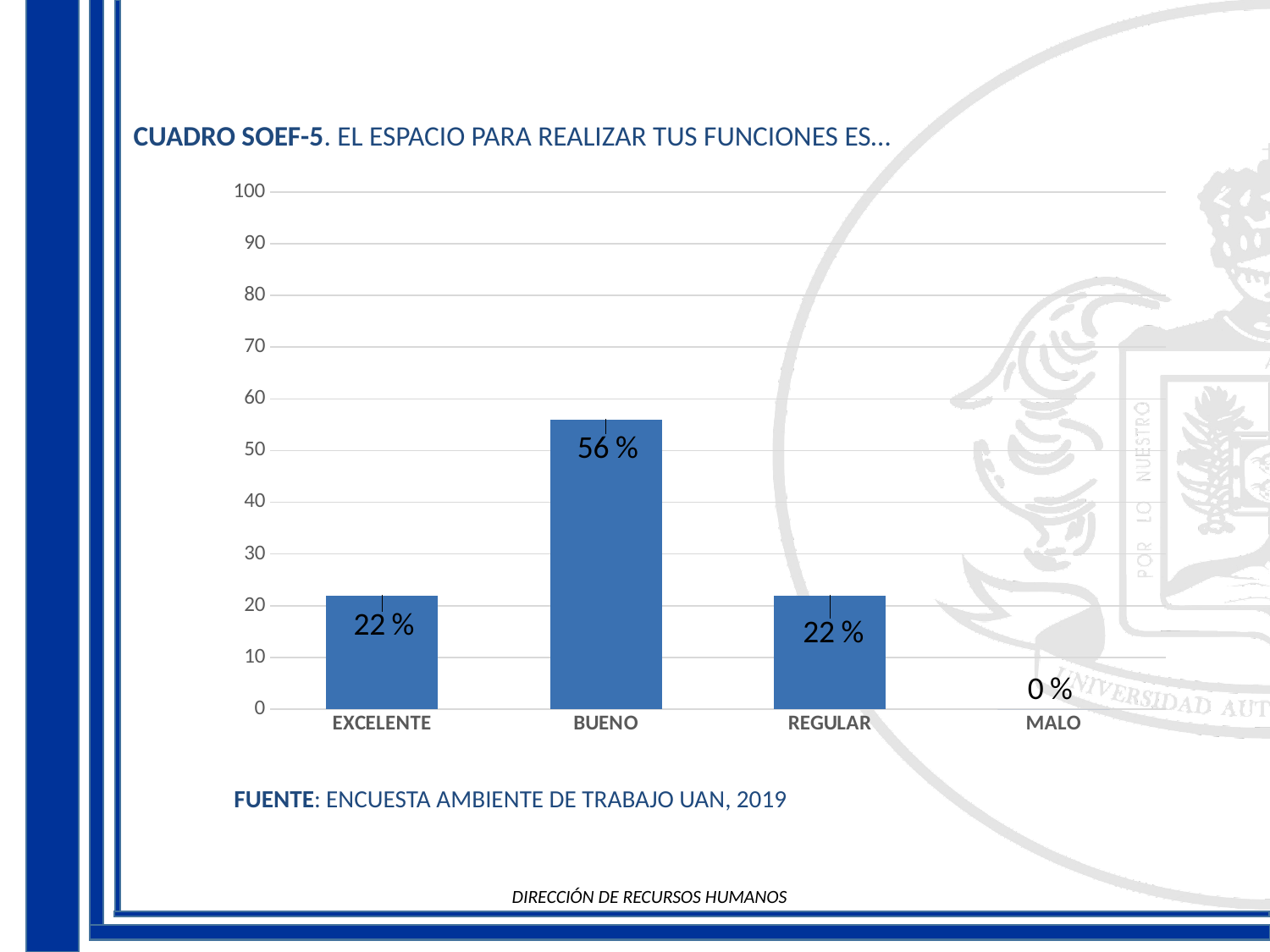
Which category has the lowest value? MALO How many categories are shown on the x axis? 4 What kind of chart is shown on the slide? bar chart Is the value for BUENO greater or less than 50? greater What is the difference between the values for BUENO and REGULAR? 34 % What is the value for BUENO? 56 % Which is larger, the value for BUENO or the value for EXCELENTE? BUENO What is the title of the chart? CUADRO SOEF-5. EL ESPACIO PARA REALIZAR TUS FUNCIONES ES… What is the value for MALO? 0 % What source is cited below the chart? ENCUESTA AMBIENTE DE TRABAJO UAN, 2019 What is the value for EXCELENTE? 22 % Which category has the highest value? BUENO